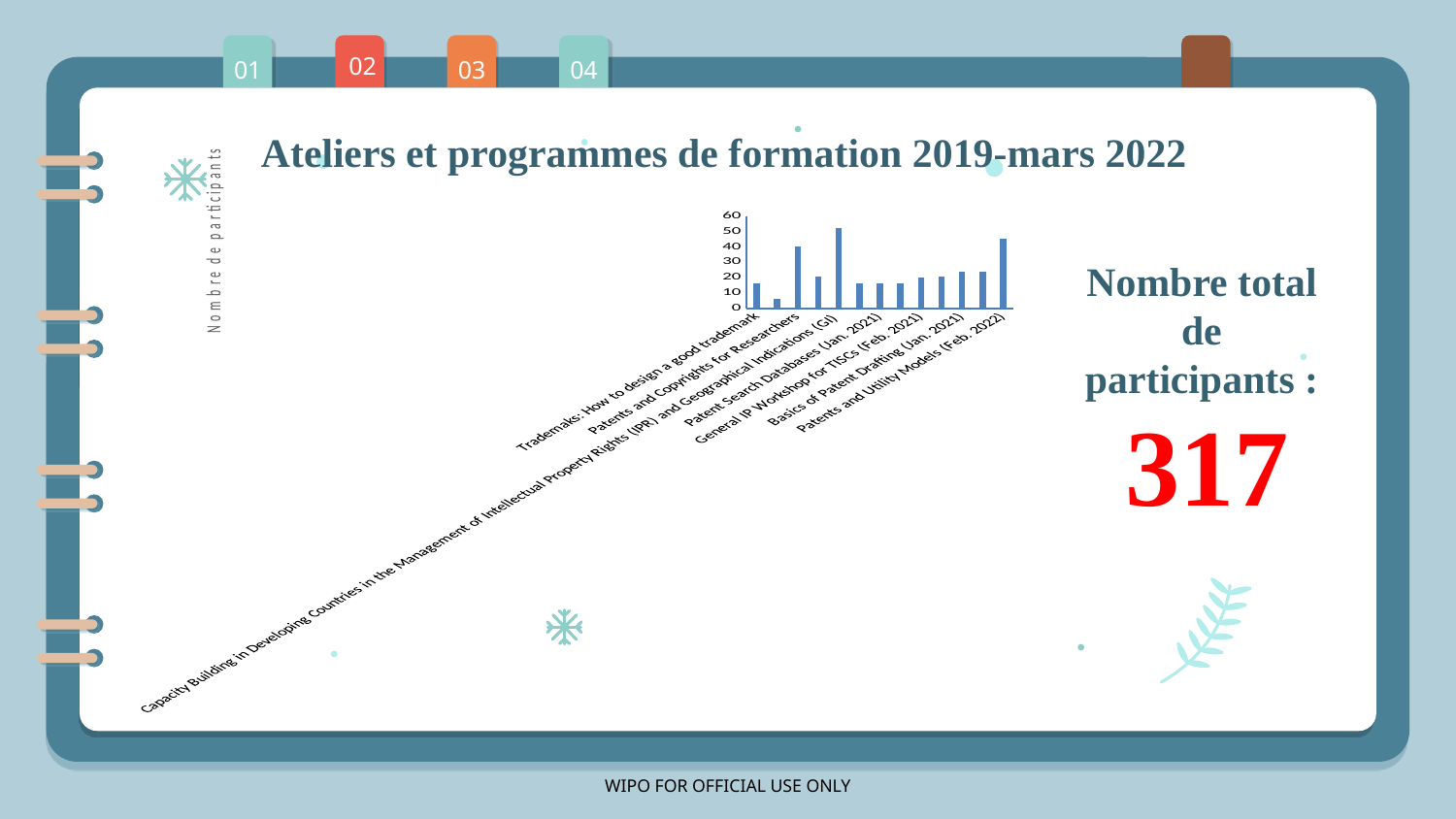
How many bars are plotted in the chart? 13 What is the highest tick value shown on the vertical axis of the chart? 60 What is the title of the slide containing the chart? Ateliers et programmes de formation 2019-mars 2022 Is the value for Capacity Building in Developing Countries in the Management of Intellectual Property Rights (IPR) and Geographical Indications (GI) greater or less than 40? greater Is the value for Patents and Utility Models (Feb. 2022) greater or less than 30? greater Is the tallest bar in the chart greater or less than 40? greater Which has the larger value: Patents and Copyrights for Researchers or Trademarks: How to design a good trademark? Patents and Copyrights for Researchers What kind of chart is shown on the slide? bar chart What total number of participants is stated next to the chart? 317